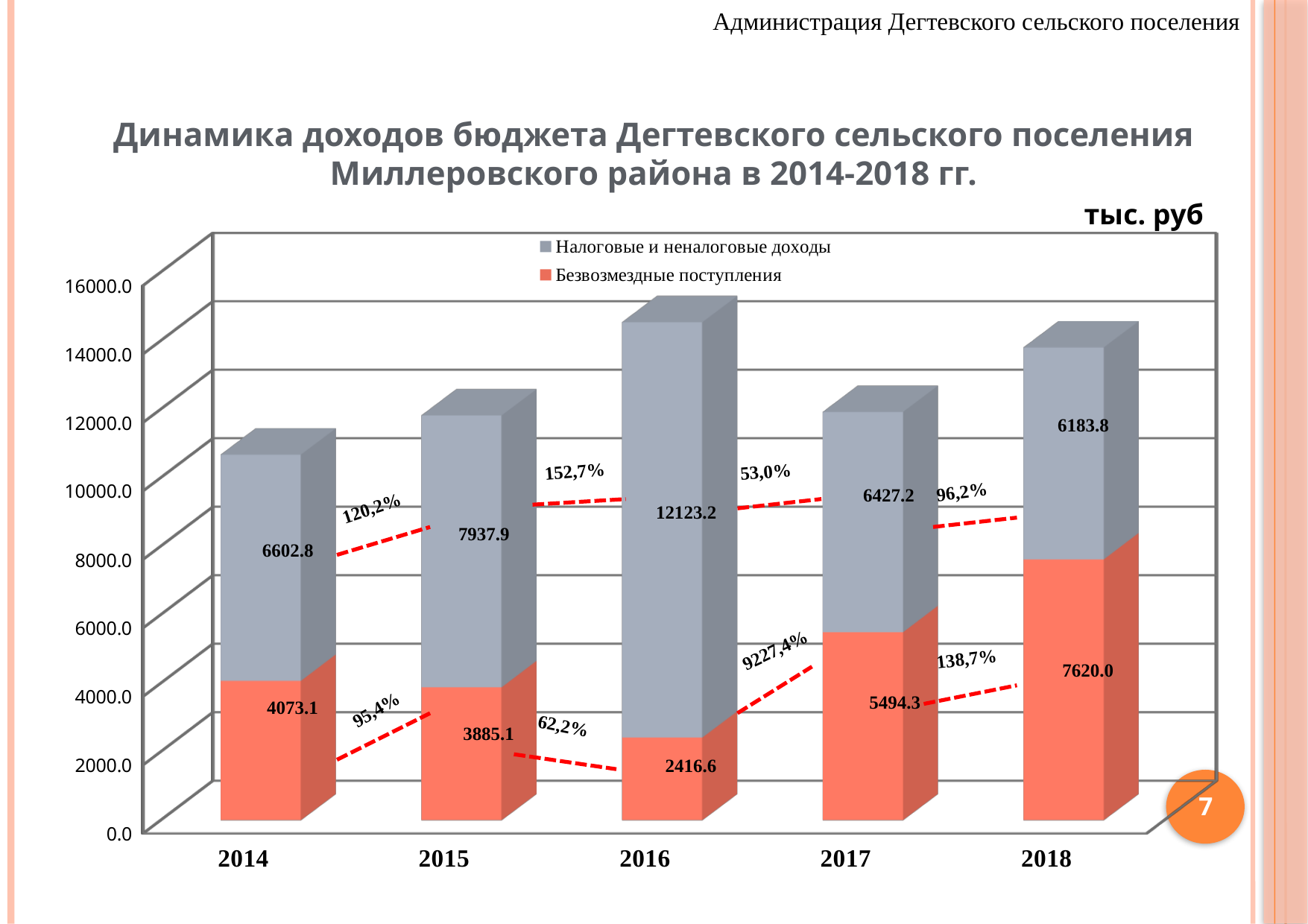
Which is larger in 2017: Налоговые и неналоговые доходы or Безвозмездные поступления? Налоговые и неналоговые доходы In which year is Безвозмездные поступления lowest? 2016 What is the total of the stacked bar for 2016? 14539.8 What is the value of Налоговые и неналоговые доходы for 2016? 12123.2 What is the total of the stacked bar for 2018? 13803.8 In which year is Налоговые и неналоговые доходы highest? 2016 What is the difference between Налоговые и неналоговые доходы in 2015 and in 2014? 1335.1 What kind of chart is shown on the slide? Stacked bar chart What is the value of Безвозмездные поступления for 2014? 4073.1 How many series does the legend list? 2 What is the value of Безвозмездные поступления for 2018? 7620.0 How many years are shown on the x axis? 5